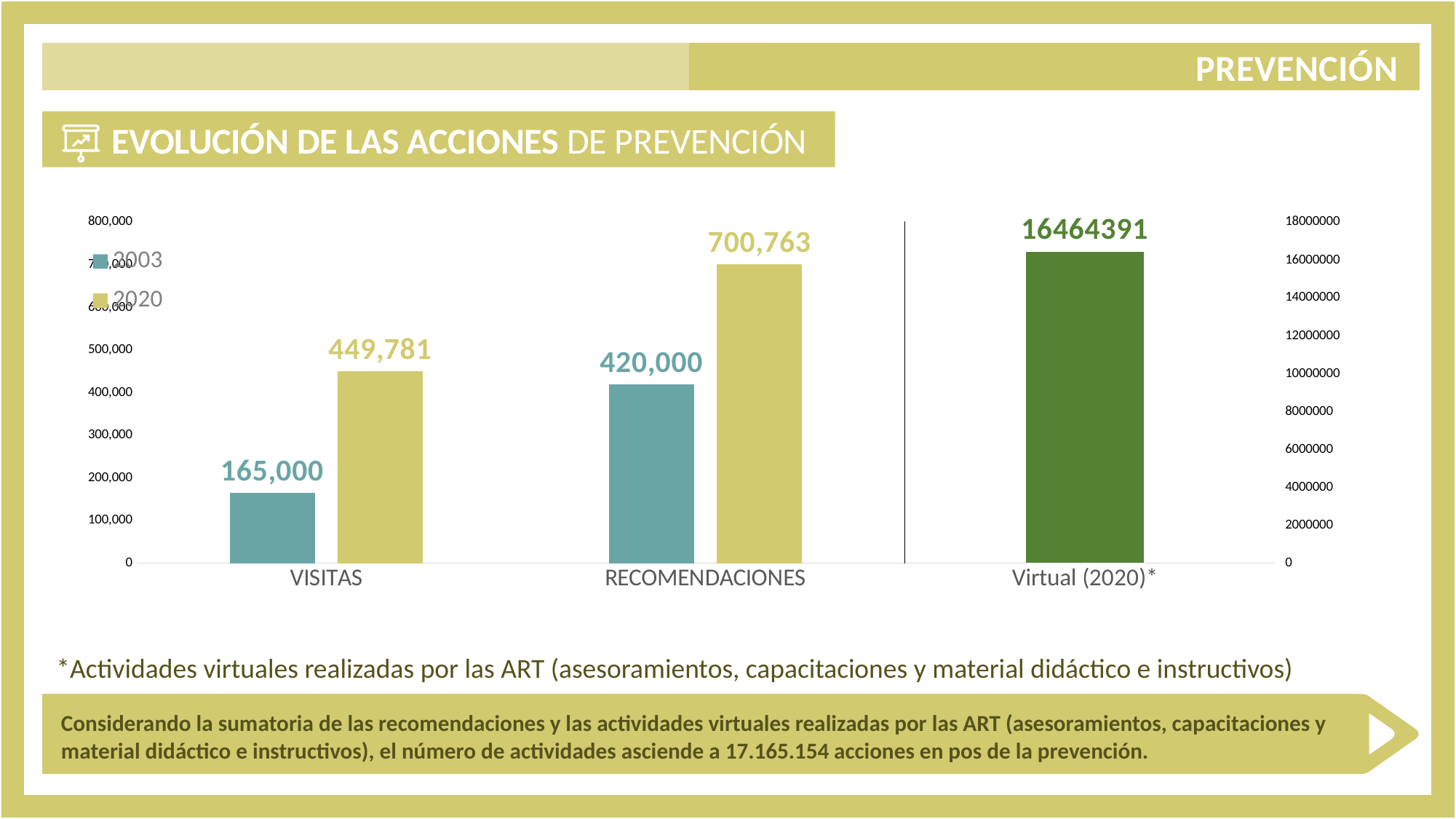
How many series does the legend list? 2 Which is larger: the 2003 value for RECOMENDACIONES or the 2020 value for VISITAS? 2020 value for VISITAS What is the value for RECOMENDACIONES in 2003? 420,000 What is the value shown for Virtual (2020)*? 16464391 What is the difference between the 2020 and 2003 values for VISITAS? 284,781 What is the value for RECOMENDACIONES in 2020? 700,763 What is the value for VISITAS in 2003? 165,000 How many categories are shown on the x axis of the chart? 3 What kind of chart is shown on the slide? Bar chart What is the value for VISITAS in 2020? 449,781 Which series has the lowest value for VISITAS? 2003 What is the difference between the 2020 and 2003 values for RECOMENDACIONES? 280,763